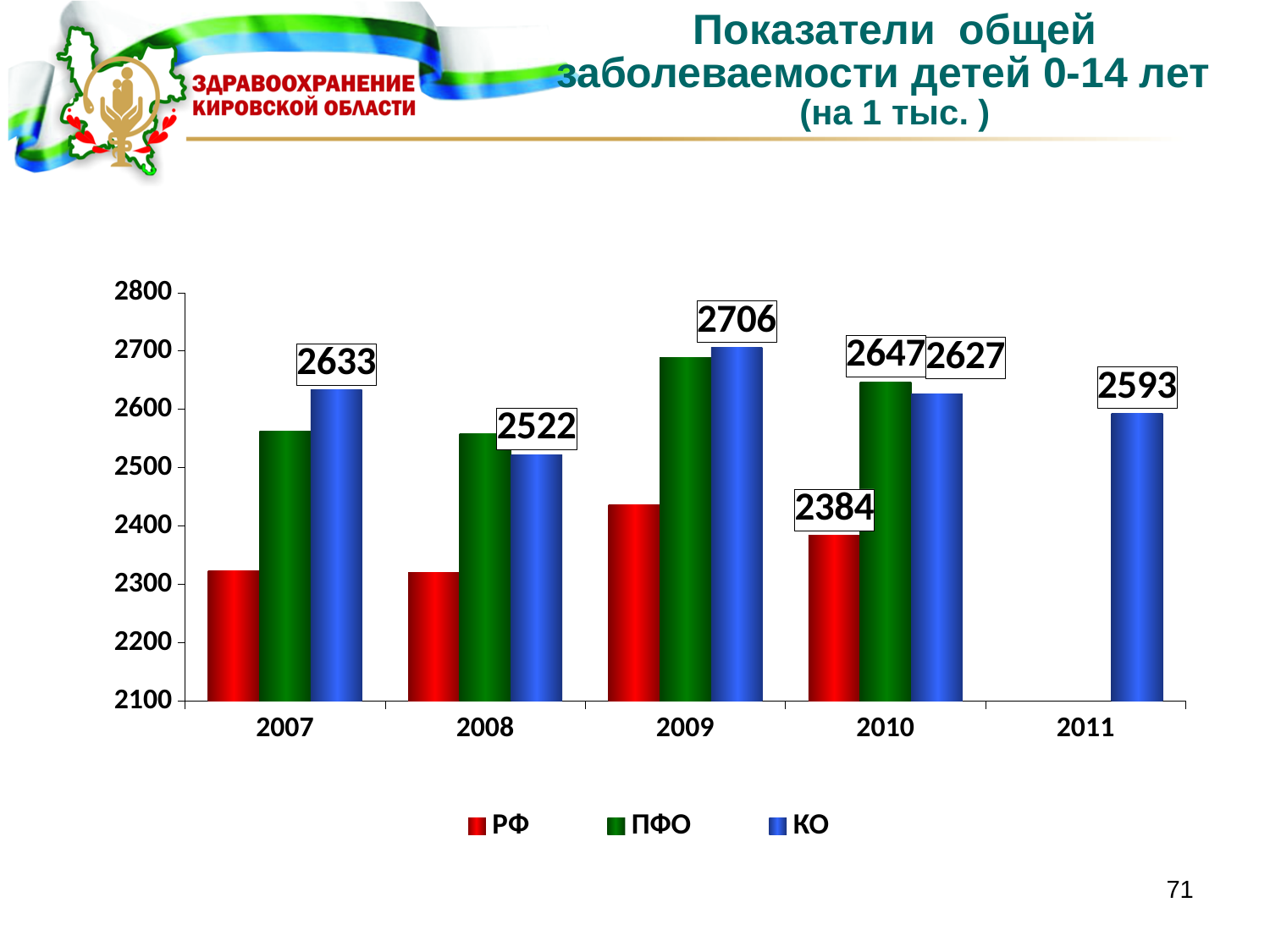
What is the value for РФ in 2010? 2384 How many series does the legend list? 3 What is the value for КО in 2007? 2633 How many years are shown on the x axis? 5 What is the difference between the КО values for 2009 and 2008? 184 In which year is the КО value lowest? 2008 In which year is the КО value highest? 2009 Is the value for РФ in 2007 greater or less than 2400? less What is the value for ПФО in 2010? 2647 In 2010, which is larger: the ПФО value or the КО value? ПФО What is the value for КО in 2009? 2706 What kind of chart is shown on the slide? bar chart